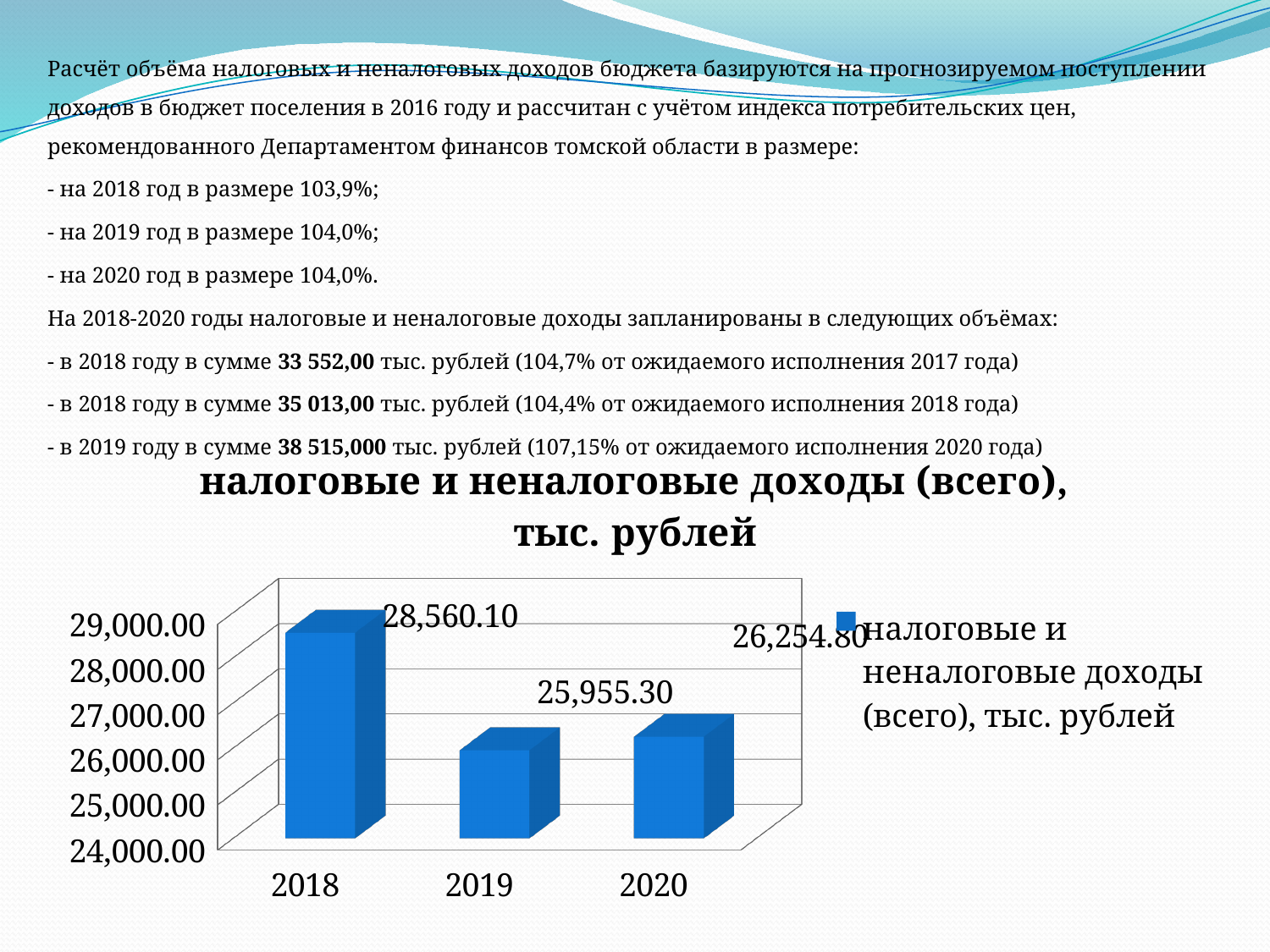
How many years are shown on the x axis of the chart? 3 Which year has the highest value in the chart? 2018 What is the difference between the values for 2018 and 2019? 2,604.80 What is the difference between the values for 2020 and 2019? 299.50 What type of chart is shown on the slide? bar chart What is the value for 2019 in the chart? 25,955.30 How many series does the chart legend list? 1 Which year has the lowest value in the chart? 2019 What is the value for 2020 in the chart? 26,254.80 Is the value for 2018 greater or less than 28,000.00? greater Which is larger, the value for 2019 or the value for 2020? 2020 What is the value for 2018 in the chart? 28,560.10